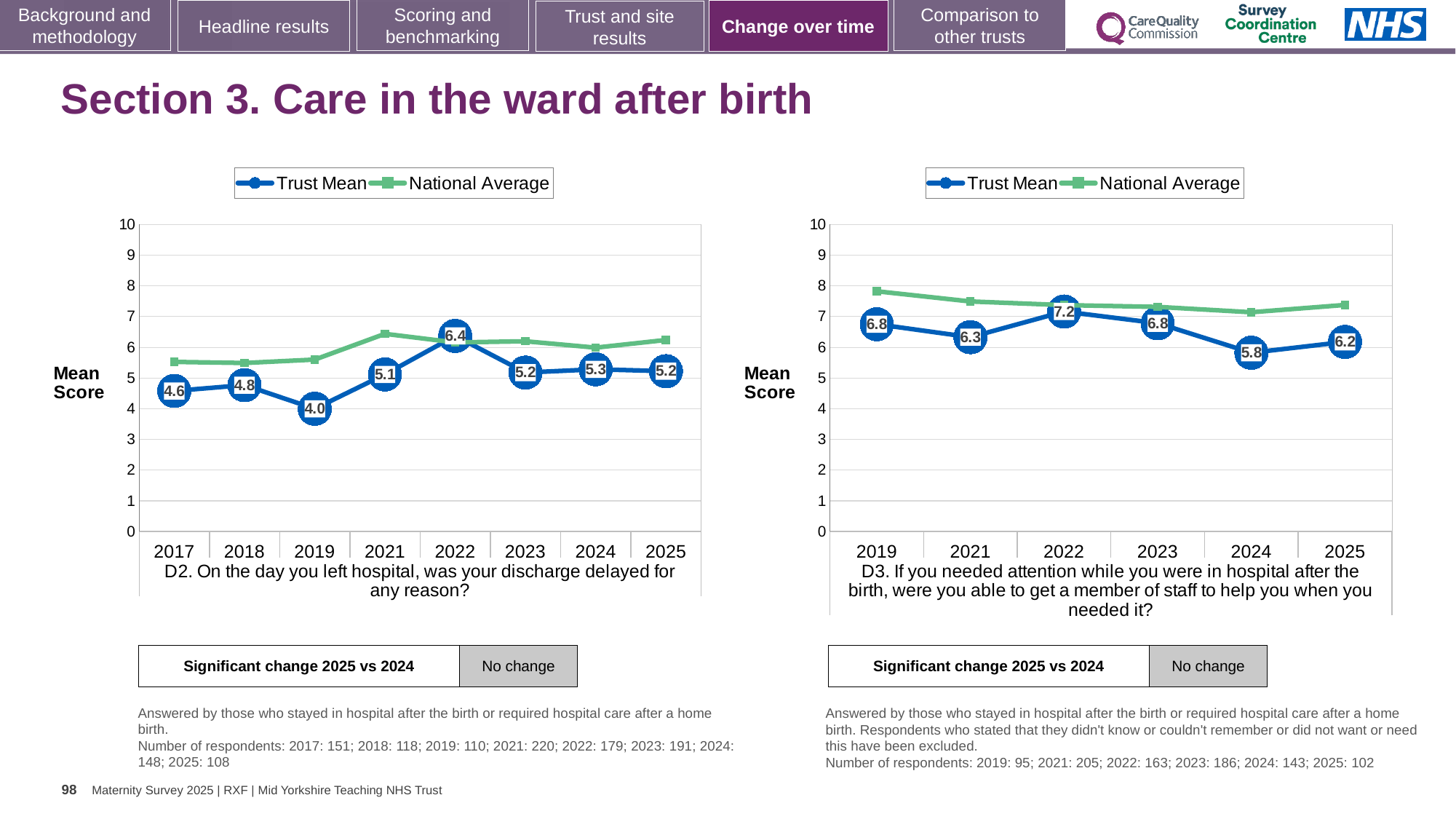
How many series does the legend of the D3 chart (right) list? 2 What type of chart is the D2 chart (left)? line chart In the D2 chart (left), is the National Average value for 2019 greater or less than 5? greater In the D2 chart (left), what is the difference between the Trust Mean scores for 2022 and 2019? 2.4 In the D3 chart (right), is the National Average value for 2019 greater or less than 7? greater In the D2 chart (left), which year has the lowest Trust Mean score? 2019 In the D3 chart (right), what is the Trust Mean score for 2024? 5.8 In the D2 chart (left), how many years are plotted on the x axis? 8 In the D3 chart (right), which year has the highest Trust Mean score? 2022 In the D3 chart (right), does the Trust Mean rise or fall from 2023 to 2024? fall In the D3 chart (right), which is larger, the Trust Mean score for 2021 or for 2025? 2021 In the D2 chart (left), what is the Trust Mean score for 2022? 6.4